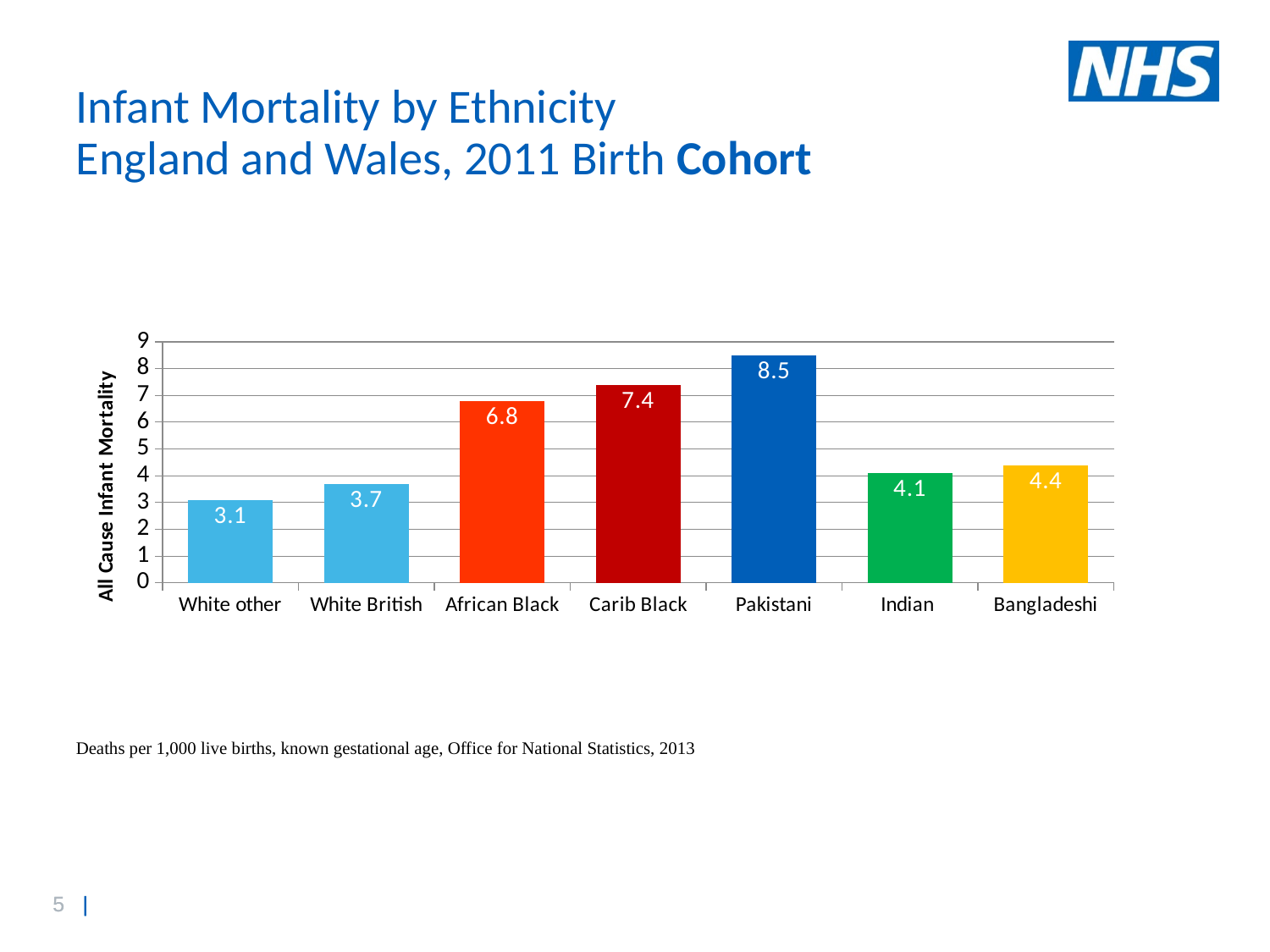
What is the label of the vertical axis? All Cause Infant Mortality Which is larger, the value for Bangladeshi or the value for Indian? Bangladeshi Which ethnicity has the lowest all cause infant mortality? White other What is the value shown for Indian? 4.1 What is the difference between the values for Carib Black and African Black? 0.6 What is the all cause infant mortality value for White other? 3.1 Is the value for African Black greater or less than 5? greater How many ethnicity categories are shown on the chart? 7 What is the all cause infant mortality value for Pakistani? 8.5 Which ethnicity has the highest all cause infant mortality? Pakistani What is the difference between the values for Pakistani and White British? 4.8 What kind of chart is shown on the slide? bar chart